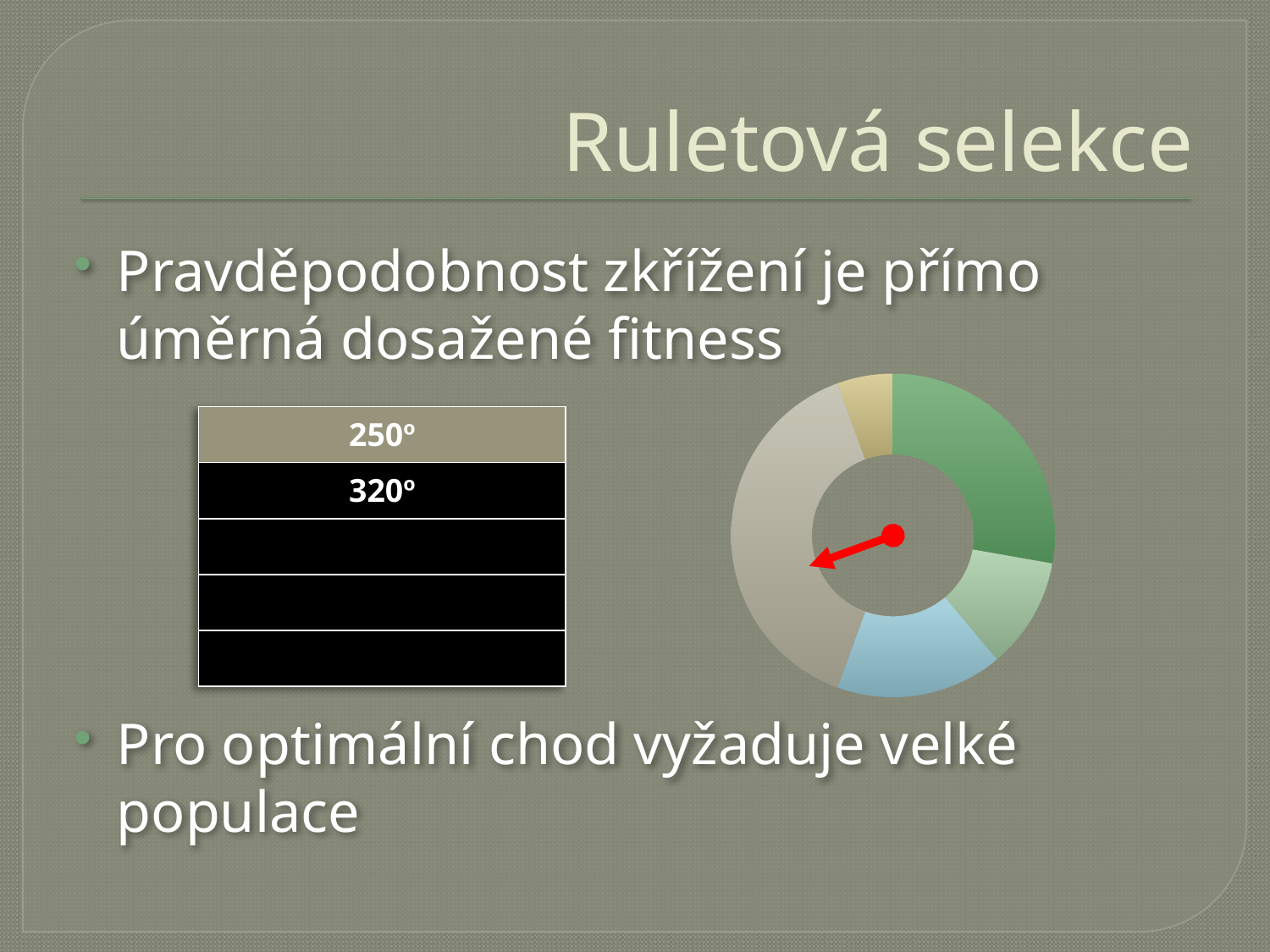
Which slice of the doughnut chart is the largest? the grey slice on the left Which slice of the doughnut chart is the smallest? the yellow slice at the top Does the doughnut chart display a legend? no Which slice of the doughnut chart does the red arrow point to? the grey slice In the doughnut chart, which is larger, the light green slice or the yellow slice? the light green slice In the doughnut chart, which is larger, the dark green slice or the light blue slice? the dark green slice How many slices does the doughnut chart have? 5 In the doughnut chart, which is larger, the grey slice or the dark green slice? the grey slice What kind of chart is shown on the right side of the slide? doughnut (pie) chart